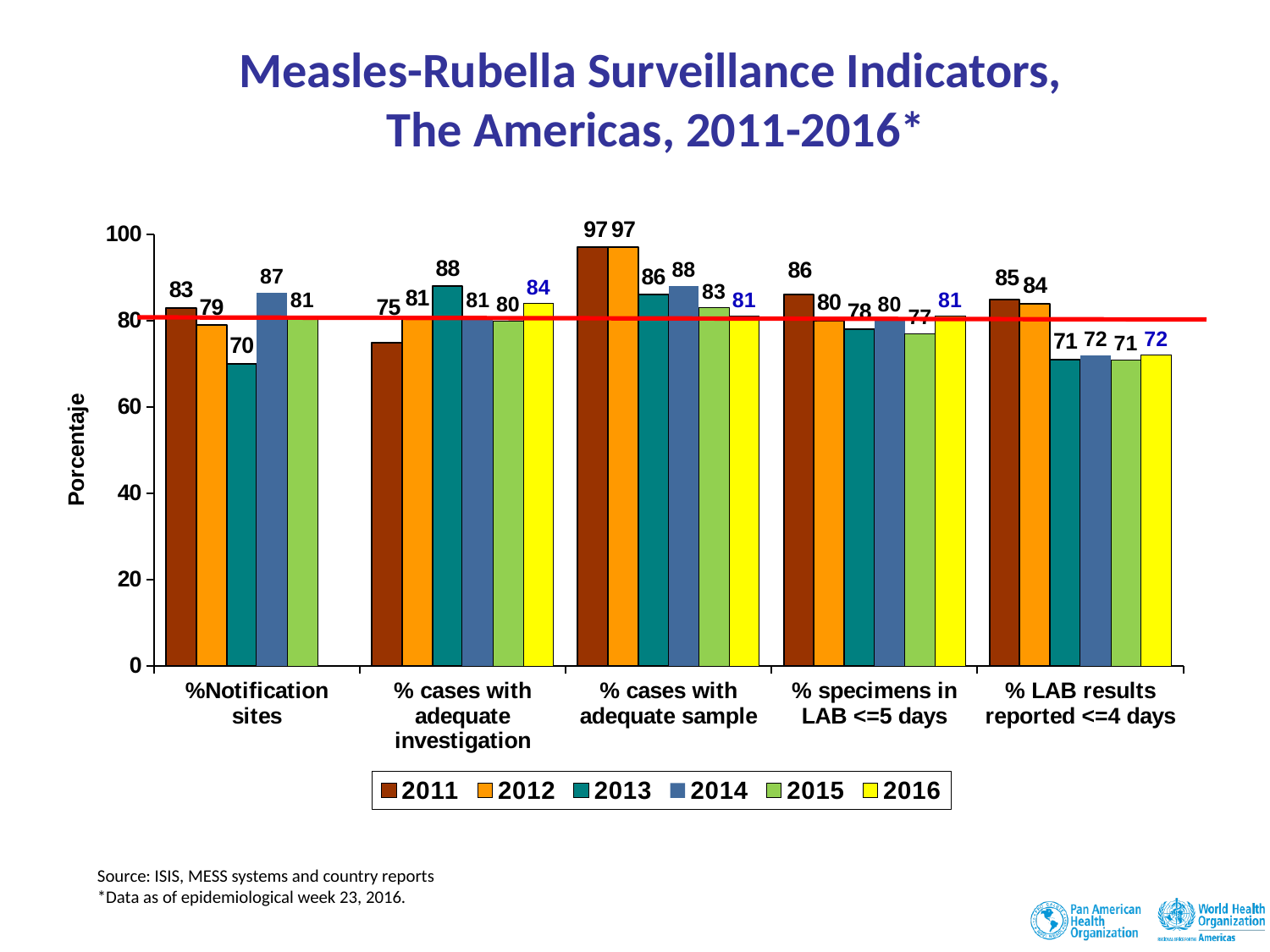
Which is larger in the % LAB results reported <=4 days category, the 2011 value or the 2012 value? 2011 Is the value for 2013 in the % specimens in LAB <=5 days category greater or less than 80? less What is the value for 2014 in the %Notification sites category? 87 Which year has the lowest value in the %Notification sites category? 2013 What is the label of the y axis? Porcentaje Which year has the highest value in the % cases with adequate investigation category? 2013 What kind of chart is shown on the slide? bar chart How many indicator categories are shown on the x axis? 5 What is the value for 2015 in the % specimens in LAB <=5 days category? 77 How many series does the legend list? 6 What is the difference between the 2011 and 2016 values in the % cases with adequate sample category? 16 What is the value for 2016 in the % cases with adequate investigation category? 84